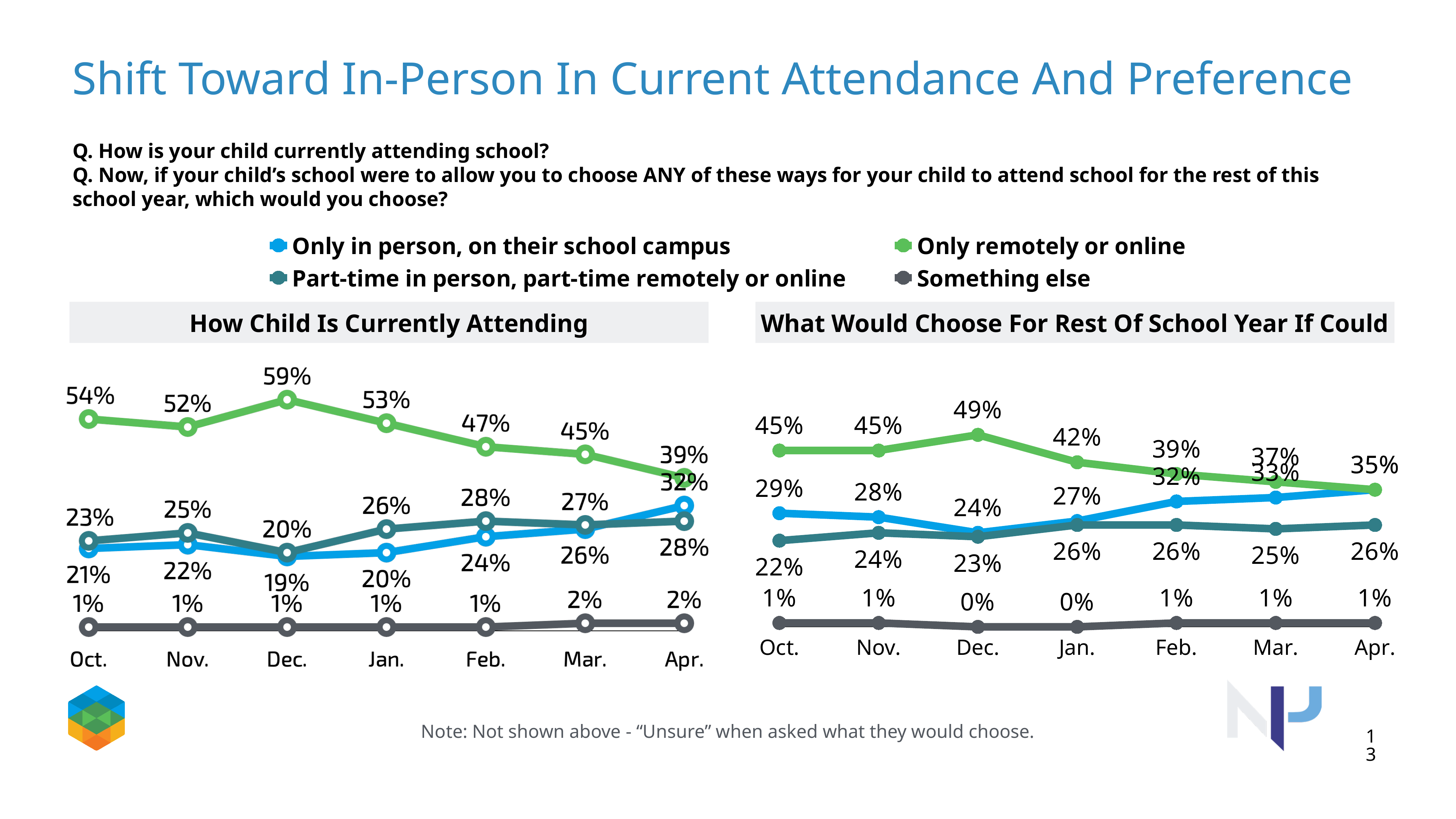
In the 'What Would Choose For Rest Of School Year If Could' chart, what is the value for 'Part-time in person, part-time remotely or online' in Jan.? 26% In the 'How Child Is Currently Attending' chart, does 'Only remotely or online' rise or fall from Dec. to Apr.? fall How many series does the legend list? 4 In the 'What Would Choose For Rest Of School Year If Could' chart, what is the difference between 'Only in person, on their school campus' in Oct. and in Dec.? 5 percentage points In the 'How Child Is Currently Attending' chart, what is the value for 'Only in person, on their school campus' in Apr.? 32% How many months are plotted on the x axis of the 'How Child Is Currently Attending' chart? 7 In the 'What Would Choose For Rest Of School Year If Could' chart, what is the value for 'Only remotely or online' in Dec.? 49% In the 'How Child Is Currently Attending' chart, what is the value for 'Only remotely or online' in Dec.? 59% In the 'How Child Is Currently Attending' chart, in which month is 'Only in person, on their school campus' lowest? Dec. In the 'How Child Is Currently Attending' chart, what is the difference between 'Only remotely or online' in Oct. and in Apr.? 15 percentage points In the 'What Would Choose For Rest Of School Year If Could' chart, which is larger in Feb.: 'Only remotely or online' or 'Only in person, on their school campus'? Only remotely or online In the 'How Child Is Currently Attending' chart, in which month is 'Only remotely or online' highest? Dec.